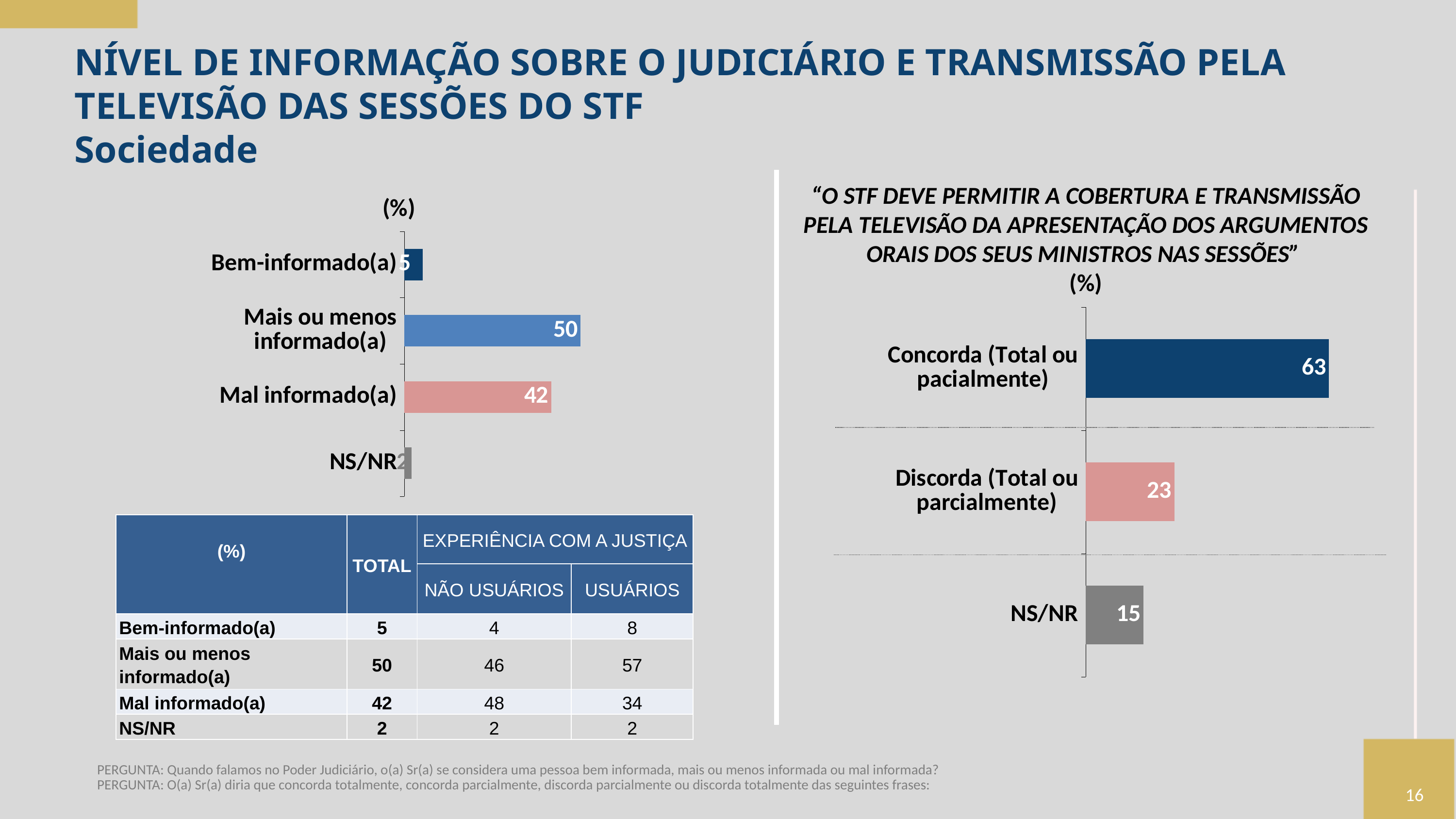
In the left-hand bar chart, which category has the highest value? Mais ou menos informado(a) In the right-hand chart about TV coverage of STF sessions, what is the difference between "Concorda" and "Discorda"? 40 In the left-hand bar chart, what is the value for "Mal informado(a)"? 42 In the left-hand bar chart, what is the difference between "Mais ou menos informado(a)" and "Mal informado(a)"? 8 What kind of chart is the left-hand chart? Bar chart In the right-hand chart about TV coverage of STF sessions, which is larger: "Concorda" or "Discorda"? Concorda (Total ou pacialmente) In the left-hand bar chart, which category has the lowest value? NS/NR In the left-hand bar chart, what is the value for "Mais ou menos informado(a)"? 50 In the right-hand chart about TV coverage of STF sessions, what is the value for "NS/NR"? 15 In the right-hand chart about TV coverage of STF sessions, what is the value for "Concorda (Total ou pacialmente)"? 63 In the right-hand chart about TV coverage of STF sessions, how many categories are plotted? 3 In the left-hand bar chart, how many categories are plotted? 4